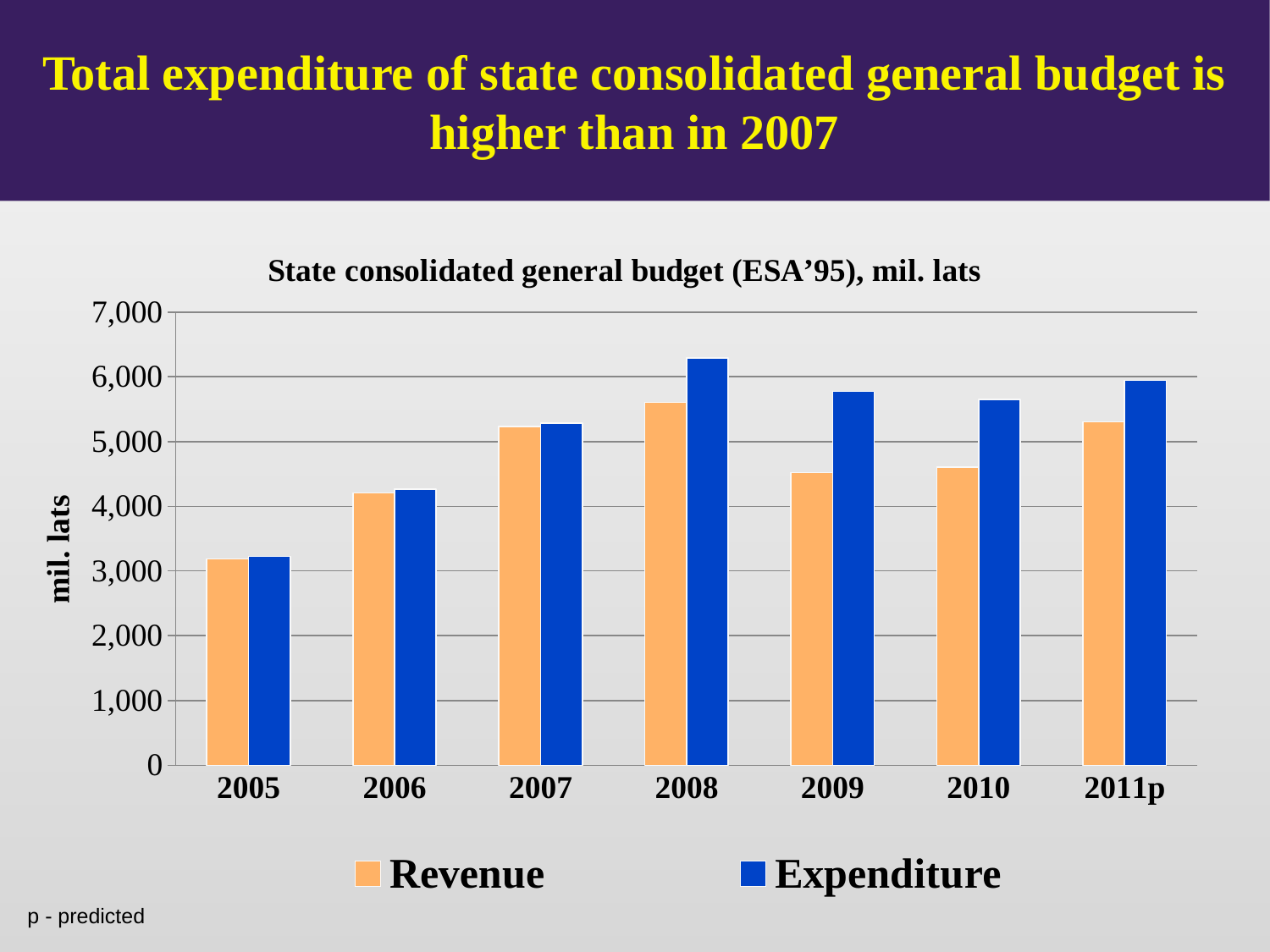
Is the Expenditure value for 2008 greater or less than 6,000? greater How many years are shown on the x axis? 7 What is the title of the chart? State consolidated general budget (ESA'95), mil. lats In which year is Revenue lowest? 2005 Is the Expenditure value for 2006 greater or less than 4,000? greater Does Revenue rise or fall from 2005 to 2008? rise Is the Revenue value for 2009 greater or less than 5,000? less In which year is Expenditure highest? 2008 In which year is Revenue highest? 2008 What kind of chart is shown on the slide? bar chart How many series does the legend list? 2 In 2009, which is larger, Revenue or Expenditure? Expenditure